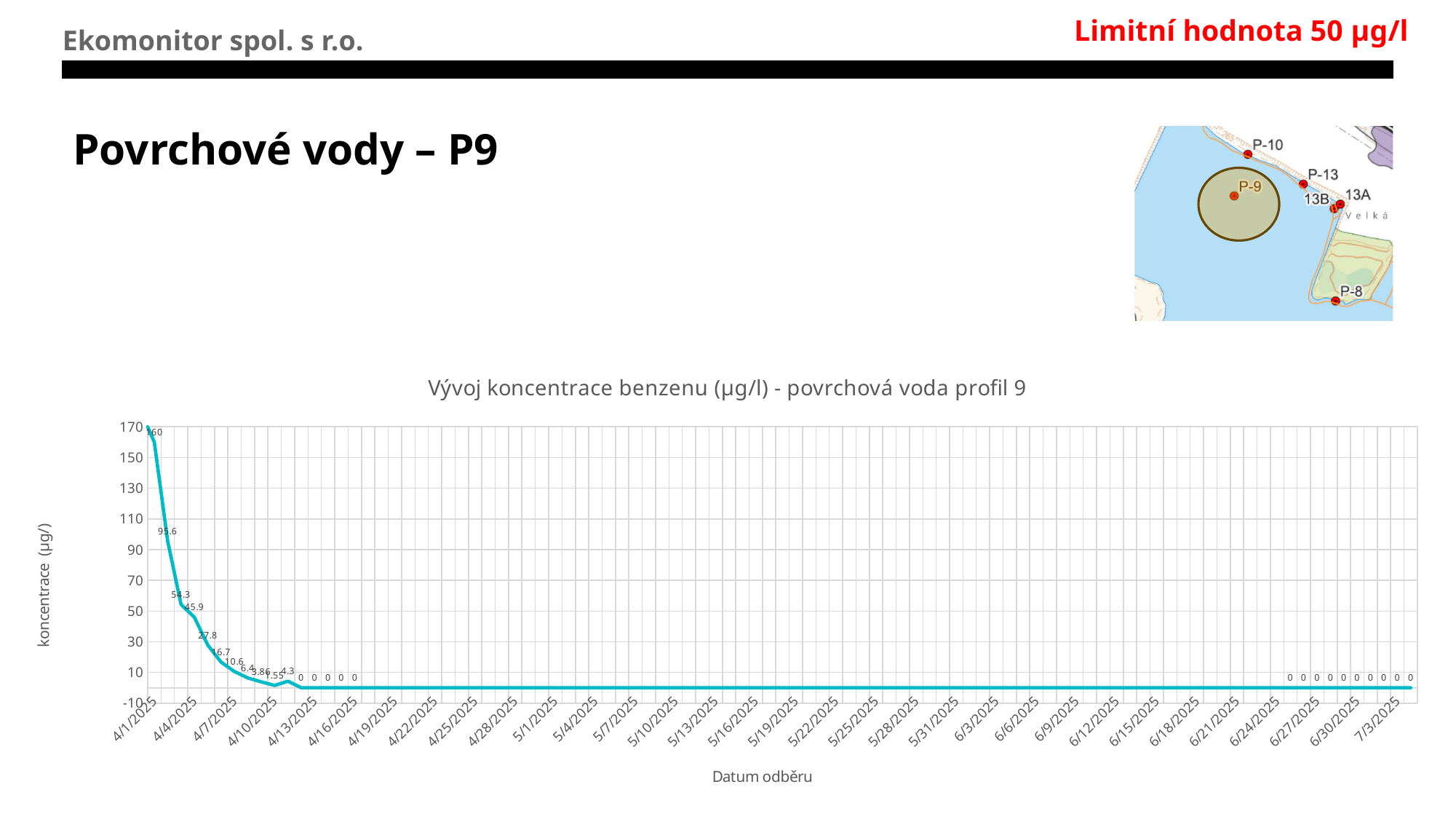
Is the value on 4/1/2025 greater or less than 150? greater What is the title of the chart? Vývoj koncentrace benzenu (µg/l) - povrchová voda profil 9 What kind of chart is shown on the slide? line chart How many labeled values on the chart are above 50? 3 Do the values generally rise or fall along the x axis from 4/1/2025 onward? fall What is the difference between the labeled values 54.3 and 45.9? 8.4 What is the value labeled at the last point of the line, at 7/3/2025? 0 What is the highest labeled value on the chart? 160 What is the difference between the first two labeled values, 160 and 95.6? 64.4 What is the benzene concentration value labeled at the first point, on 4/1/2025? 160 What is the lowest labeled value on the chart? 0 What is the label of the x axis of the chart? Datum odběru